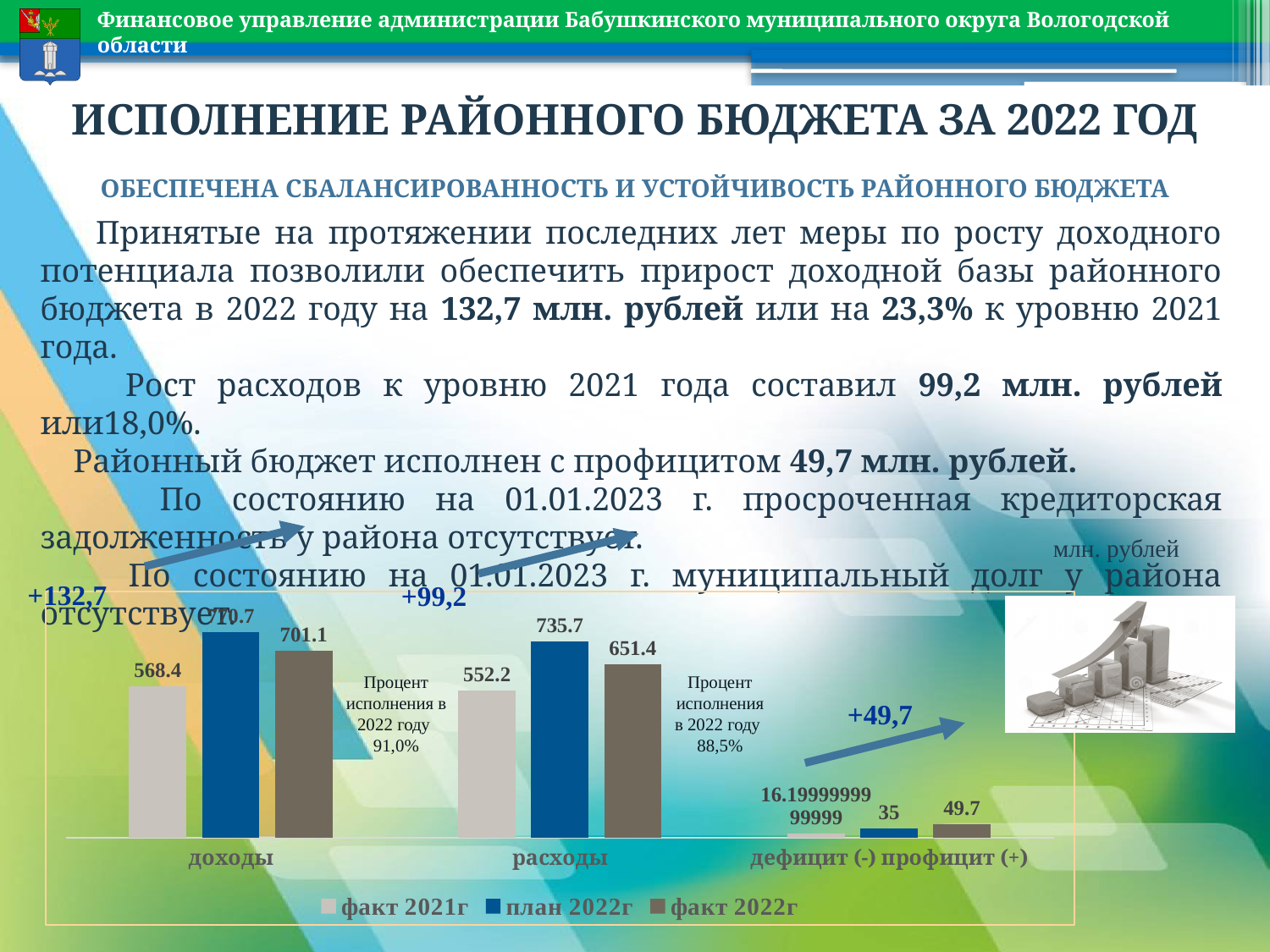
What is the value of факт 2022г for дефицит (-) профицит (+)? 49.7 What is the value of факт 2022г for доходы? 701.1 What is the value of план 2022г for расходы? 735.7 For расходы, which is larger: план 2022г or факт 2022г? план 2022г What is the difference between факт 2022г and факт 2021г for доходы? 132.7 How many categories are shown on the x axis? 3 What kind of chart is shown on the slide? bar chart What is the value of факт 2022г for расходы? 651.4 What is the difference between факт 2022г and факт 2021г for расходы? 99.2 What is the value of факт 2021г for доходы? 568.4 How many series does the legend list? 3 What is the value of план 2022г for дефицит (-) профицит (+)? 35